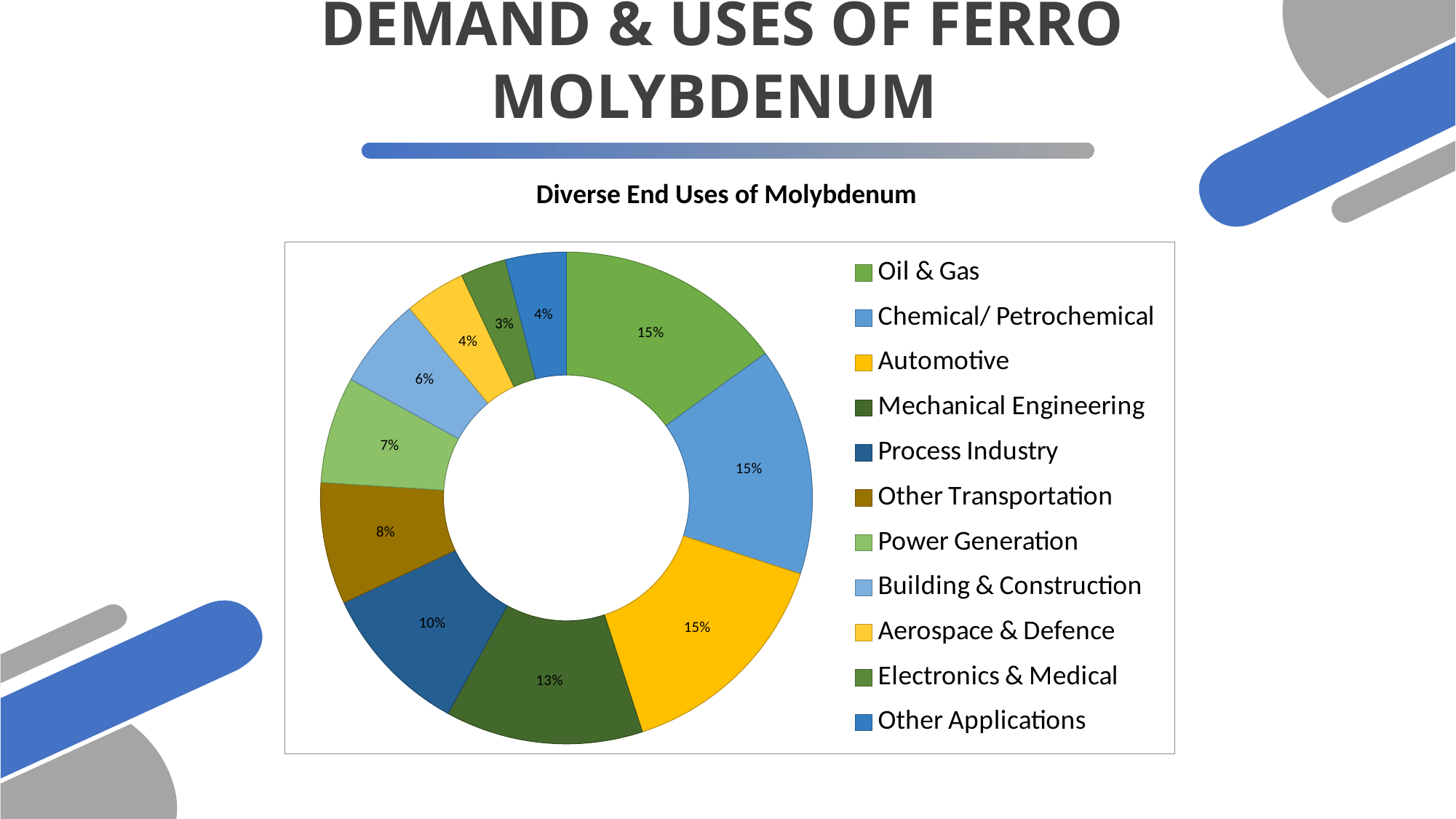
How many categories does the legend list? 11 What share does Mechanical Engineering have? 13% What type of chart is shown on the slide? Doughnut chart What share does Building & Construction have? 6% Which category has the smallest share? Electronics & Medical What share does Process Industry have? 10% What is the chart's title? Diverse End Uses of Molybdenum Which is larger, Power Generation or Building & Construction? Power Generation What share does Electronics & Medical have? 3% What is the difference between the shares of Mechanical Engineering and Process Industry? 3% What is the combined share of Oil & Gas and Automotive? 30% What share does Other Transportation have? 8%